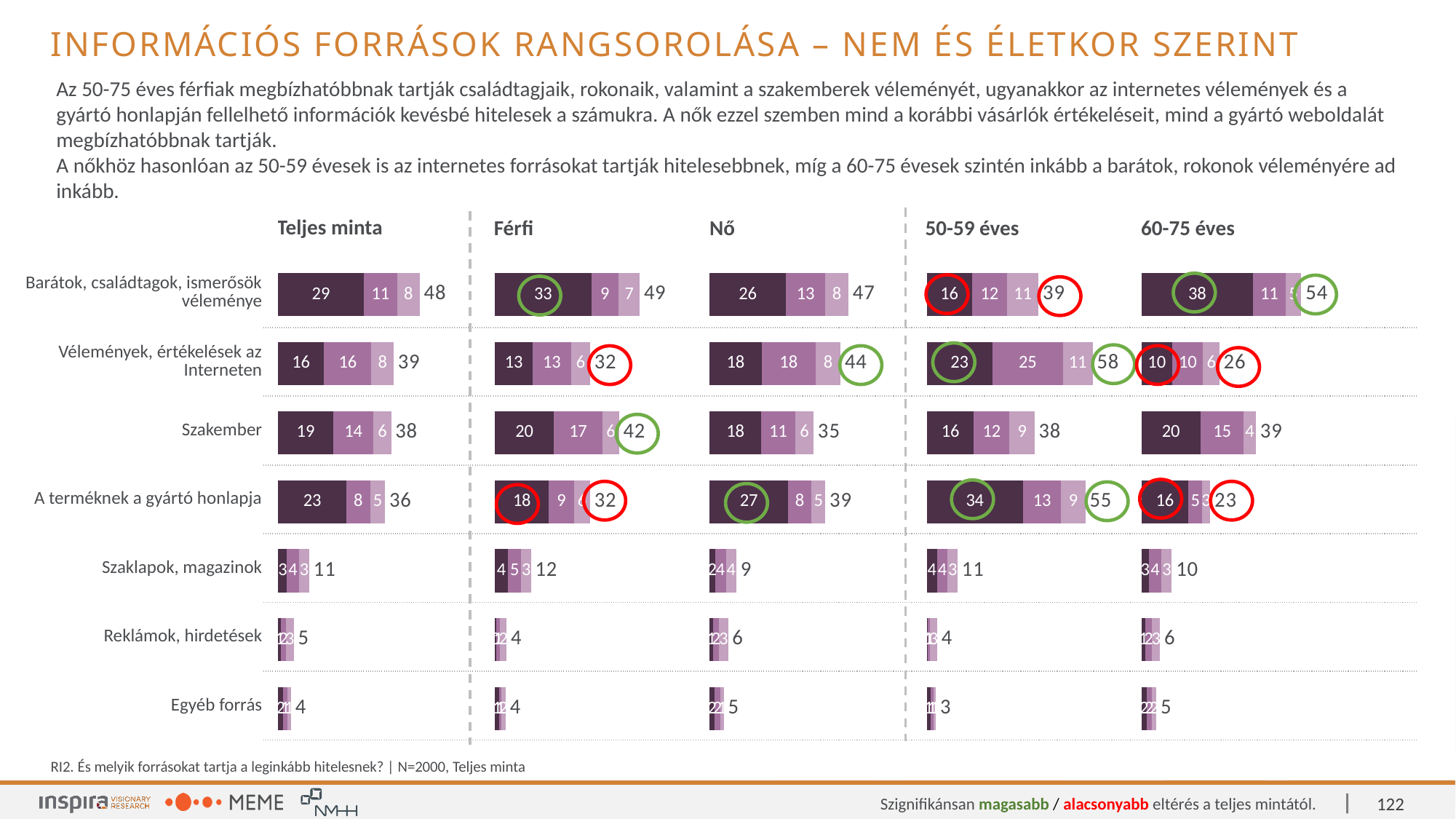
In the Teljes minta chart, which category has the lowest total? Egyéb forrás In the Nő chart, what is the difference between the totals for 'Barátok, családtagok, ismerősök véleménye' and 'Vélemények, értékelések az Interneten'? 3 In the 50-59 éves chart, which category has the highest total? Vélemények, értékelések az Interneten For 'Vélemények, értékelések az Interneten', what is the difference between the Nő total and the Férfi total? 12 In the Férfi chart, which category has the highest total? Barátok, családtagok, ismerősök véleménye In the Nő chart, what is the total value for 'Szakember'? 35 In the Teljes minta chart, what is the total value shown for 'Barátok, családtagok, ismerősök véleménye'? 48 How many categories (information sources) are listed in each chart? 7 For 'A terméknek a gyártó honlapja', which chart shows the larger total: 50-59 éves or 60-75 éves? 50-59 éves What kind of chart is used on this slide? Stacked bar chart In the Férfi chart, what is the value of the first (darkest) segment for 'Barátok, családtagok, ismerősök véleménye'? 33 In the 60-75 éves chart, what is the total value for 'Vélemények, értékelések az Interneten'? 26